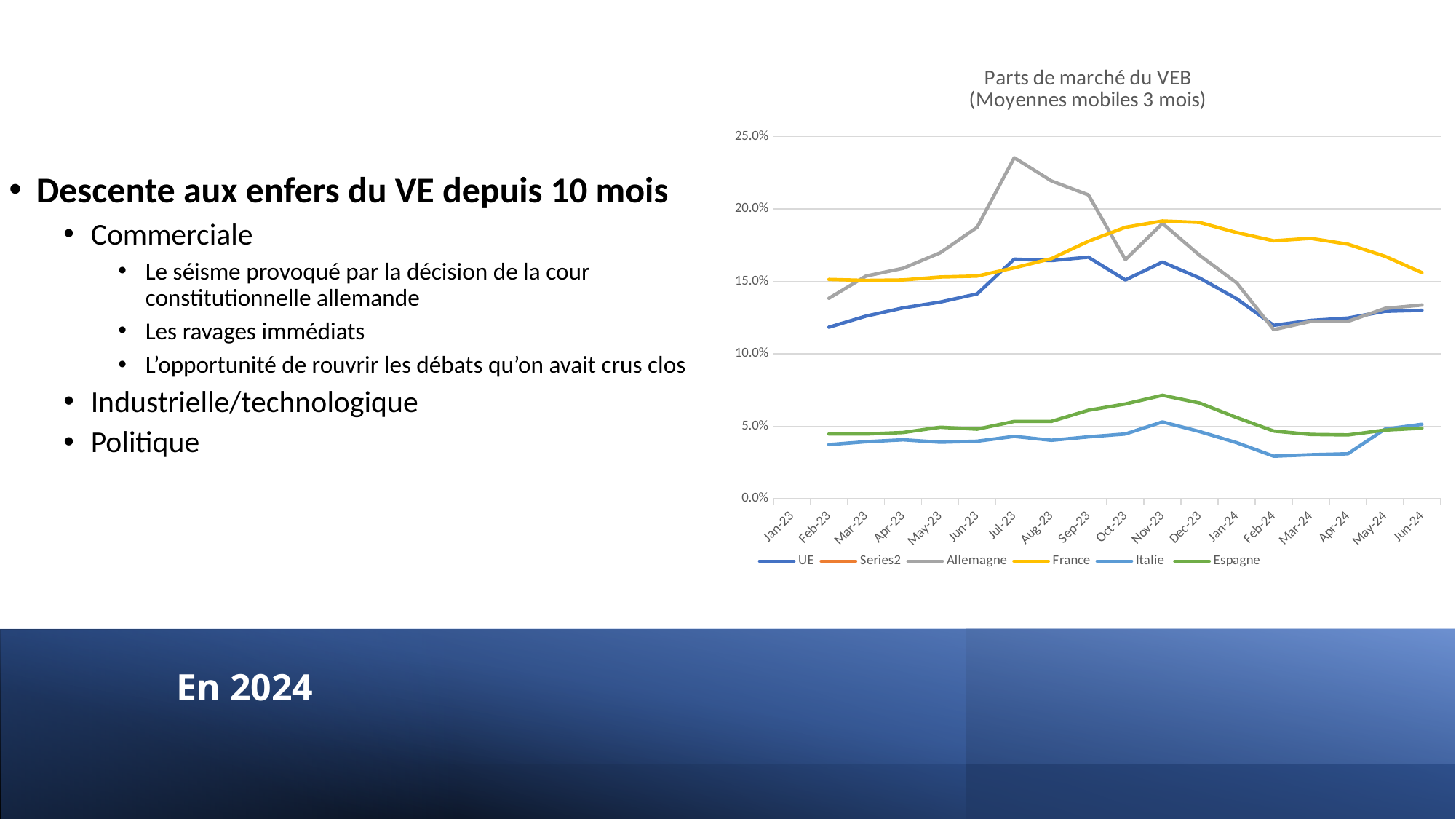
How many months are shown along the x axis of the chart? 18 Is the value for UE at Feb-23 greater or less than 15.0%? less Which series reaches the highest value anywhere on the chart? Allemagne Does the Allemagne line rise or fall between Jul-23 and Feb-24? fall Is the value for France at Nov-23 greater or less than 15.0%? greater Is the value for Allemagne at Jul-23 greater or less than 20.0%? greater At Jul-23, which series has the larger value, Allemagne or France? Allemagne How many series does the chart legend list? 6 What kind of chart is shown on the slide? line chart At Nov-23, which series has the larger value, Espagne or Italie? Espagne What is the title of the chart? Parts de marché du VEB (Moyennes mobiles 3 mois)